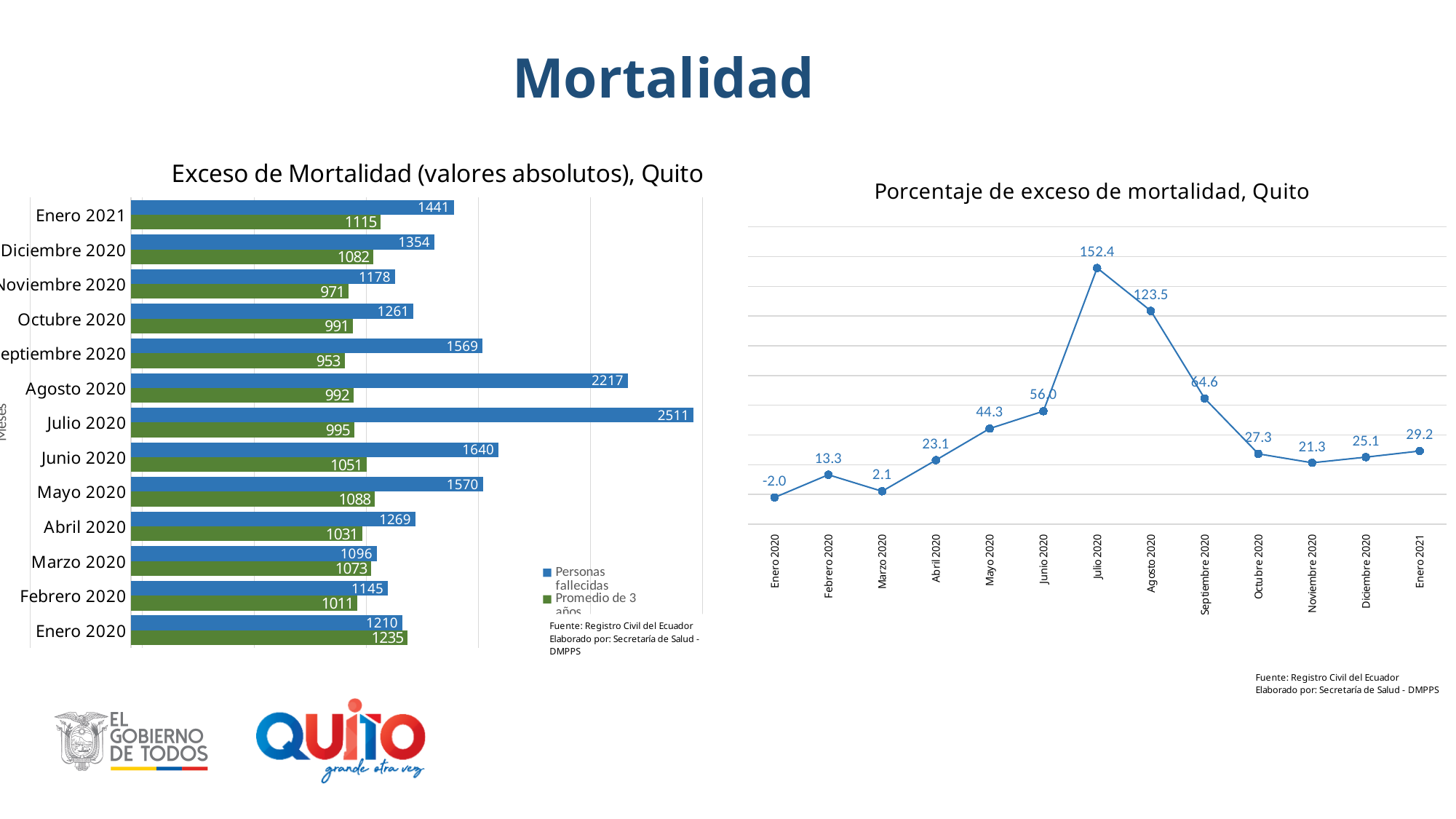
In the 'Exceso de Mortalidad (valores absolutos), Quito' chart, which month has the highest value of Personas fallecidas? Julio 2020 In the 'Exceso de Mortalidad (valores absolutos), Quito' chart, what is the value of Personas fallecidas for Julio 2020? 2511 What kind of chart is 'Porcentaje de exceso de mortalidad, Quito'? Line chart In the 'Porcentaje de exceso de mortalidad, Quito' chart, which month has the lowest value? Enero 2020 In the 'Porcentaje de exceso de mortalidad, Quito' chart, what is the value for Julio 2020? 152.4 In the 'Exceso de Mortalidad (valores absolutos), Quito' chart, what is the value of Promedio de 3 años for Enero 2021? 1115 What kind of chart is 'Exceso de Mortalidad (valores absolutos), Quito'? Bar chart In the 'Porcentaje de exceso de mortalidad, Quito' chart, do the values rise or fall from Julio 2020 to Octubre 2020? Fall In the 'Exceso de Mortalidad (valores absolutos), Quito' chart, which is larger for Enero 2020: Personas fallecidas or Promedio de 3 años? Promedio de 3 años In the 'Exceso de Mortalidad (valores absolutos), Quito' chart, what is the difference between Personas fallecidas and Promedio de 3 años for Agosto 2020? 1225 In the 'Exceso de Mortalidad (valores absolutos), Quito' chart, how many series does the legend list? 2 In the 'Porcentaje de exceso de mortalidad, Quito' chart, how many months are plotted? 13